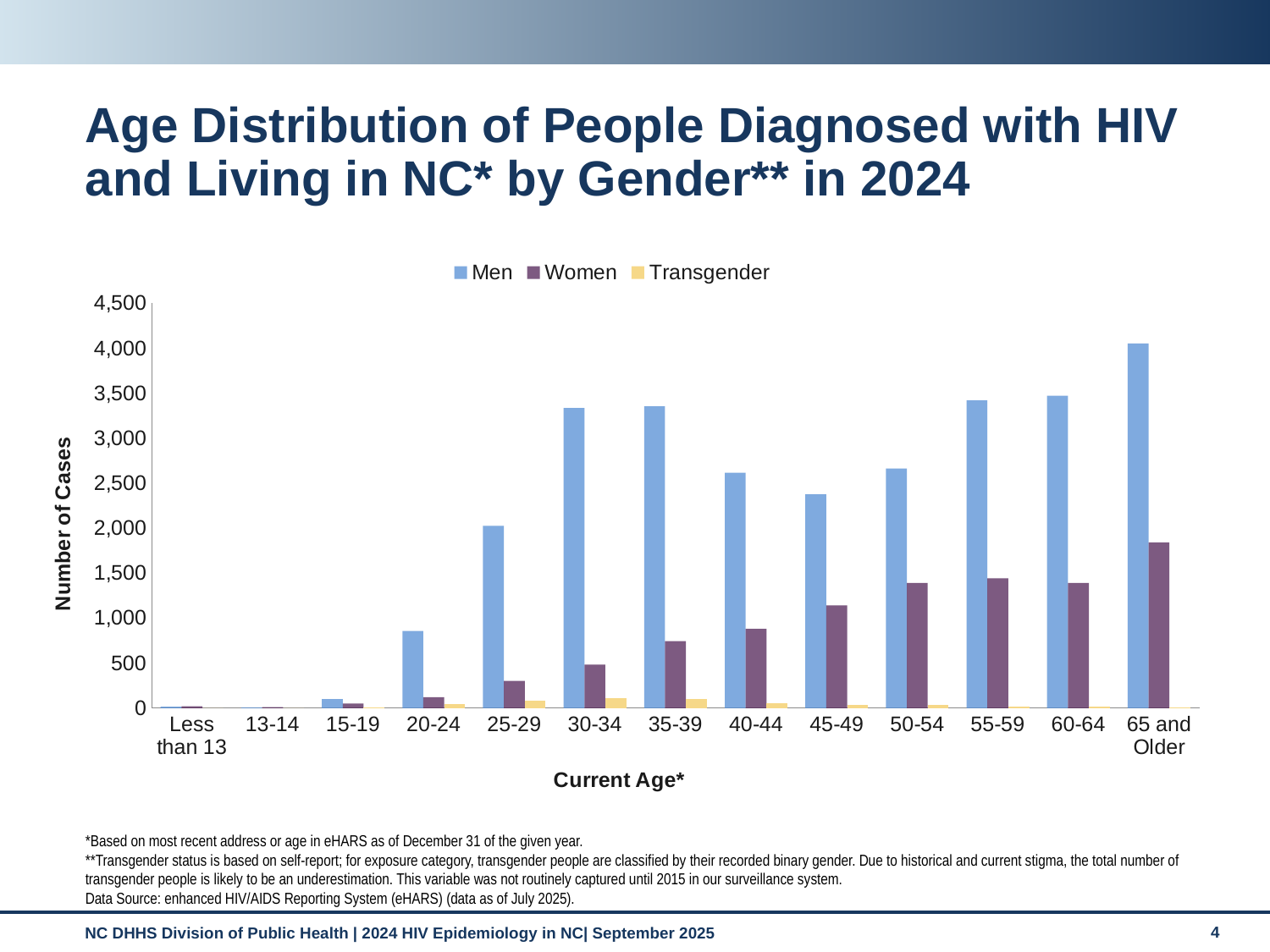
Is the value for Men in the 65 and Older category greater or less than 3,500? greater Which is larger for Men: the 40-44 category or the 45-49 category? 40-44 What kind of chart is shown on the slide? bar chart Is the value for Men in the 45-49 category greater or less than 2,500? less Which age category has the highest number of cases for Women? 65 and Older Is the value for Men in the 30-34 category greater or less than 3,000? greater How many age categories are shown on the x axis? 13 How many series does the legend list? 3 Which age category has the highest number of cases for Men? 65 and Older Which colour represents the Transgender series in the legend? yellow